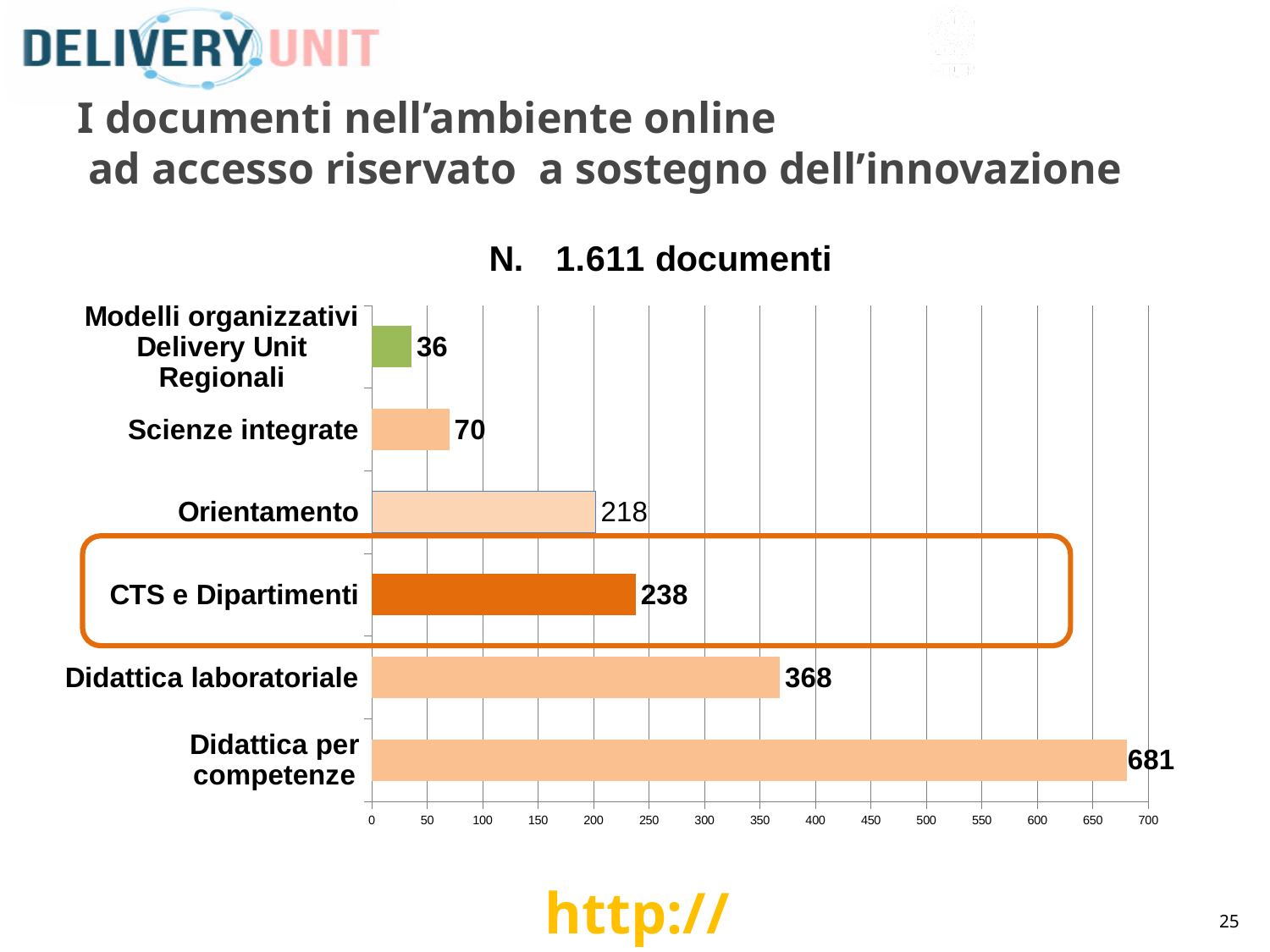
What is the title shown above the chart? N. 1.611 documenti What is the value for Didattica per competenze? 681 Which category has the lowest value? Modelli organizzativi Delivery Unit Regionali Which is larger, Didattica laboratoriale or CTS e Dipartimenti? Didattica laboratoriale How many categories are shown in the chart? 6 What is the difference between CTS e Dipartimenti and Orientamento? 20 What kind of chart is shown on the slide? Bar chart What is the value for Scienze integrate? 70 What is the value for Orientamento? 218 What is the value for CTS e Dipartimenti? 238 What is the difference between Didattica per competenze and Didattica laboratoriale? 313 Which category has the highest value? Didattica per competenze